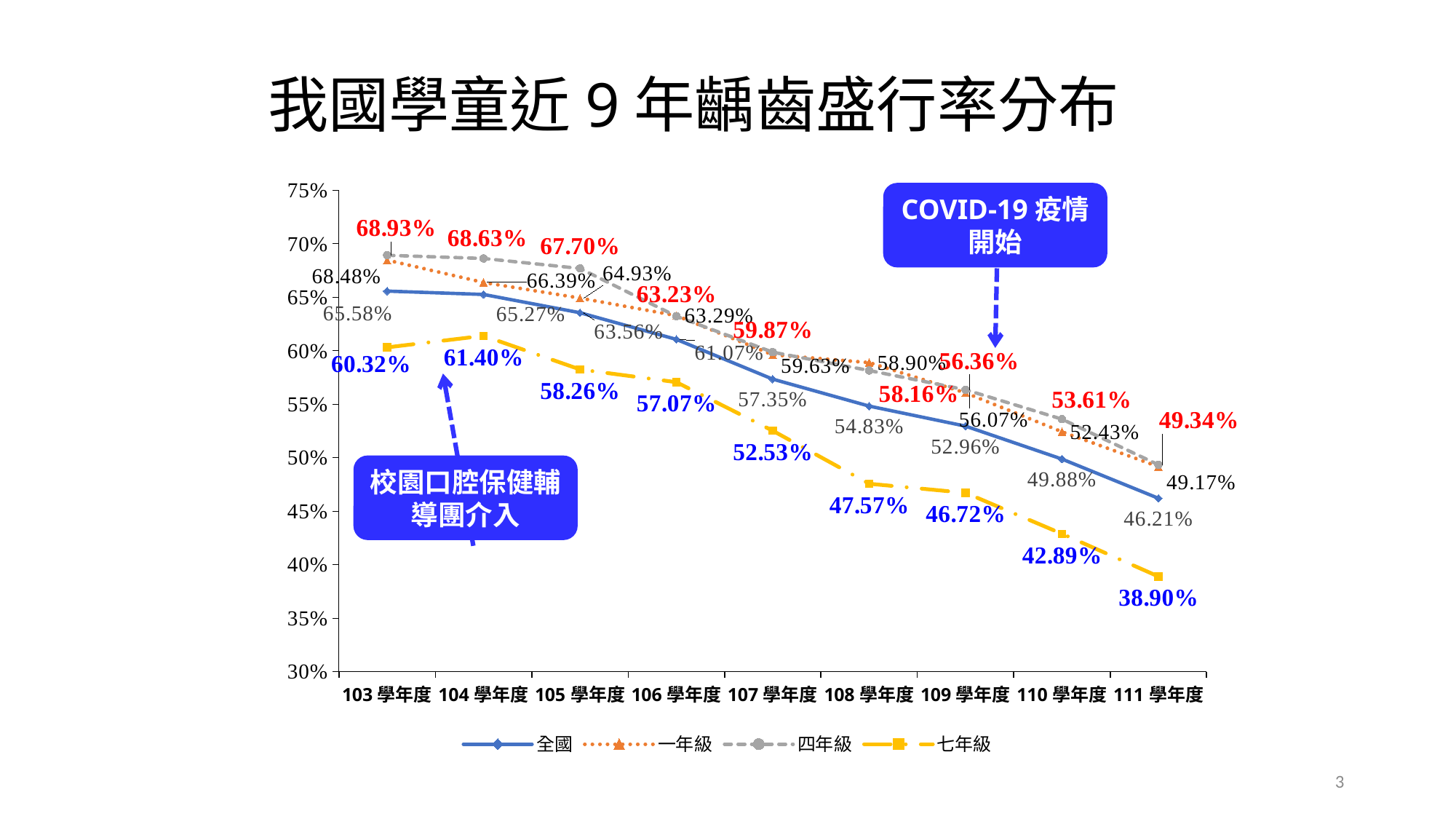
Does the 全國 line rise or fall from 103 學年度 to 111 學年度? Fall What is the 全國 value for 111 學年度? 46.21% By how many percentage points did the 全國 value fall from 103 學年度 to 111 學年度? 19.37 percentage points In which school year is the 七年級 value highest? 104 學年度 In which school year is the 全國 value lowest? 111 學年度 What is the 全國 value for 103 學年度? 65.58% Is the 四年級 value for 105 學年度 greater or less than 65%? greater How many school years (學年度) are plotted along the x axis? 9 How many series does the legend list? 4 What is the 七年級 value for 111 學年度? 38.90% Which is higher at 107 學年度, 全國 or 七年級? 全國 What kind of chart is shown on the slide? Line chart